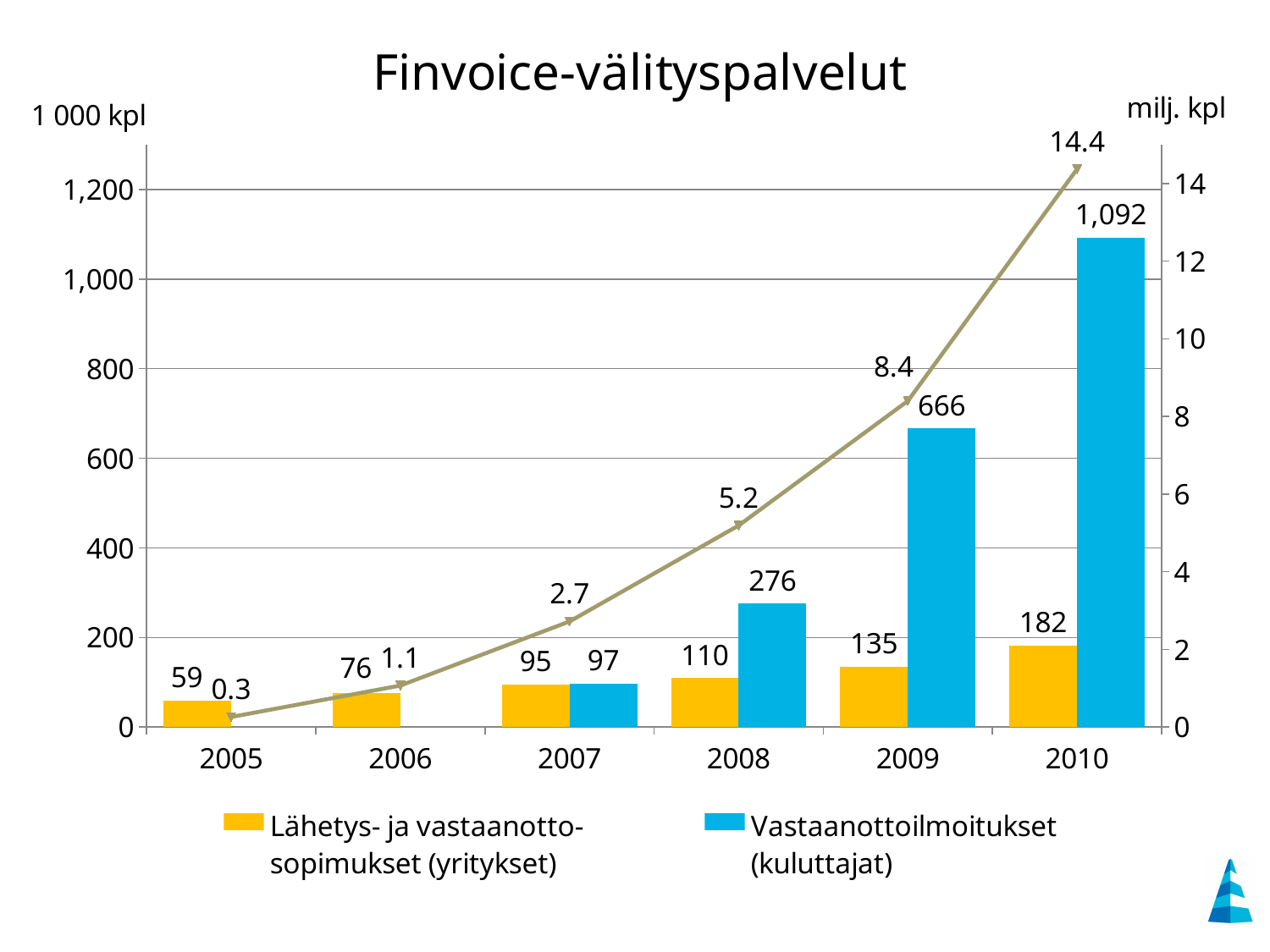
In which year is Lähetys- ja vastaanottosopimukset (yritykset) lowest? 2005 Does the value of Lähetys- ja vastaanottosopimukset (yritykset) rise or fall from 2005 to 2010? Rise How many years are shown on the x axis? 6 What value does the line series show for 2008? 5.2 What kind of chart is shown on the slide? Bar chart with a line What is the difference between the Vastaanottoilmoitukset (kuluttajat) values for 2010 and 2009? 426 In 2007, which series has the larger value: Lähetys- ja vastaanottosopimukset (yritykset) or Vastaanottoilmoitukset (kuluttajat)? Vastaanottoilmoitukset (kuluttajat) What is the value of Lähetys- ja vastaanottosopimukset (yritykset) in 2010? 182 What is the value of Vastaanottoilmoitukset (kuluttajat) in 2009? 666 What unit is shown on the right-hand axis? milj. kpl How many series does the legend list? 2 In which year is Vastaanottoilmoitukset (kuluttajat) highest? 2010